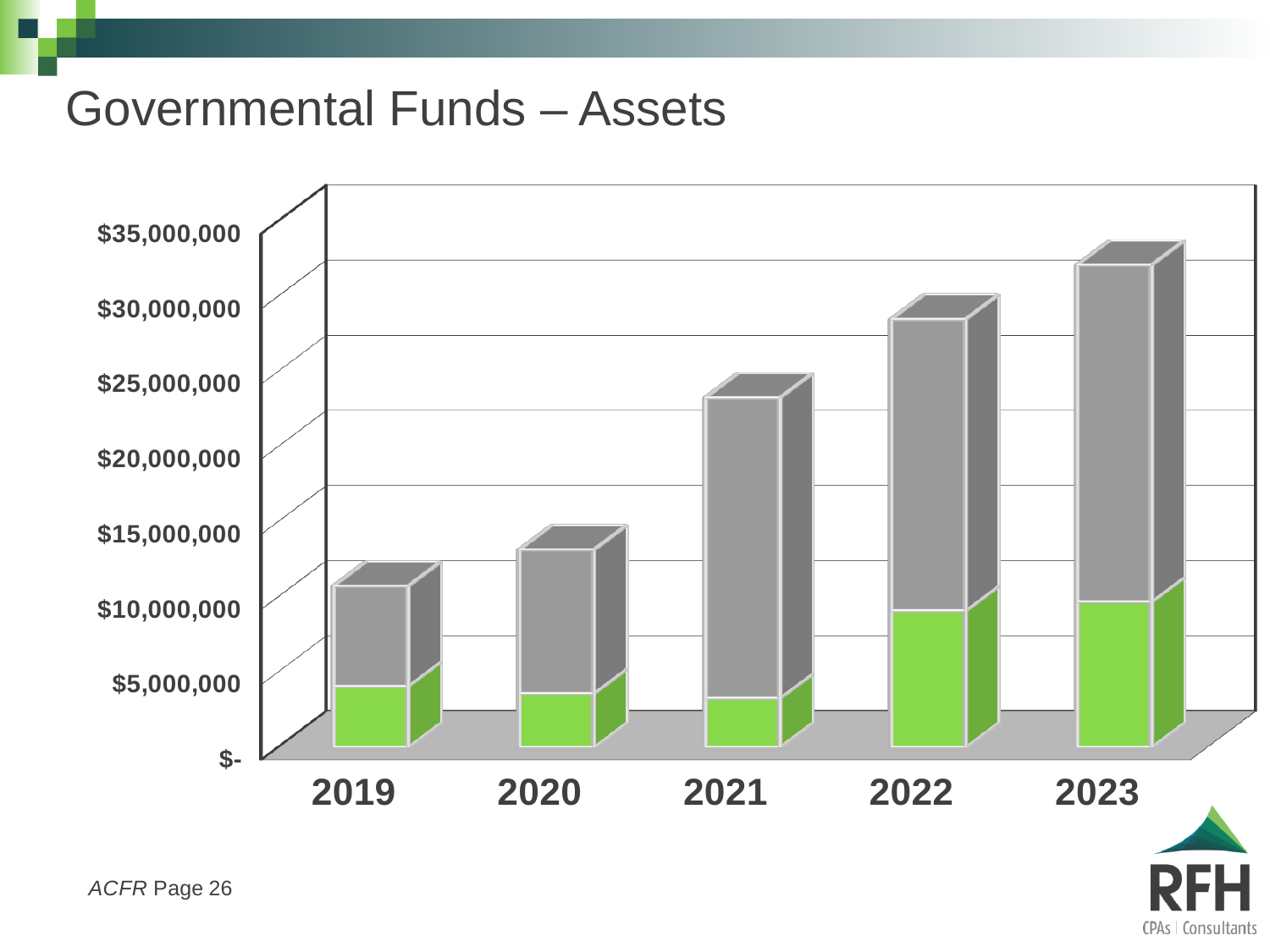
Which year has the lowest total bar? 2019 What is the title of the slide containing the chart? Governmental Funds – Assets Do the total bar heights rise or fall from 2019 to 2023? rise Is the total bar for 2020 greater or less than $15,000,000? less Is the total bar for 2022 greater or less than $25,000,000? greater Is the total bar for 2021 greater or less than $25,000,000? less Which total bar is taller, 2021 or 2022? 2022 How many years are shown on the x axis of the chart? 5 Which year has the highest total bar? 2023 What kind of chart is shown on the slide? bar chart